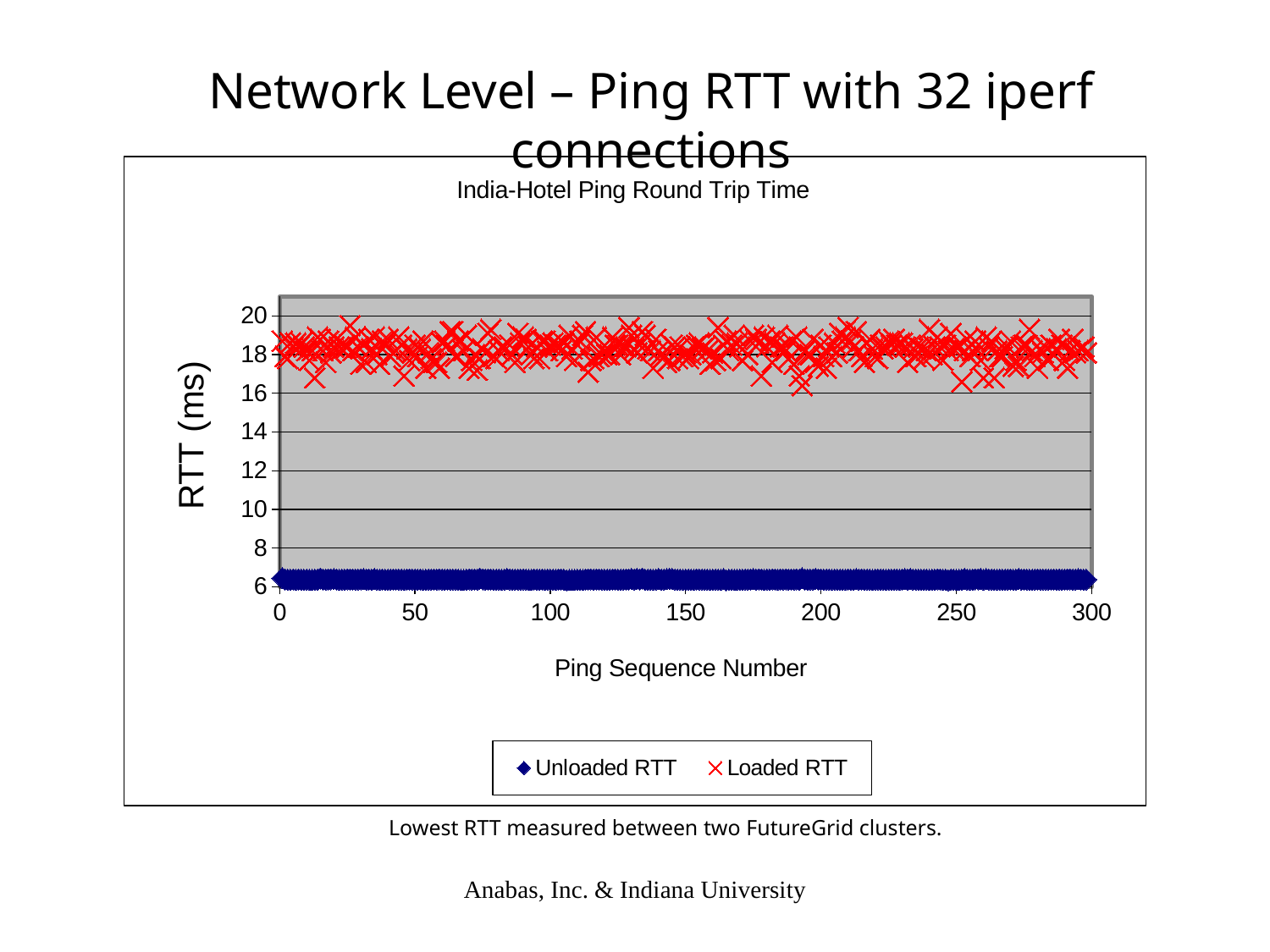
How many series does the legend list? 2 Are the Unloaded RTT values greater or less than 8 ms? less Are the Loaded RTT values greater or less than 20 ms? less Which series has the larger RTT values, Unloaded RTT or Loaded RTT? Loaded RTT What is the title of the chart? India-Hotel Ping Round Trip Time Which series is plotted with red x markers? Loaded RTT What kind of chart is shown on the slide? scatter chart Are the Loaded RTT values generally greater or less than 14 ms? greater What is the highest value shown on the x axis (Ping Sequence Number)? 300 Do the Unloaded RTT values rise, fall, or stay roughly flat as the ping sequence number increases? stay roughly flat Do the Loaded RTT values show a clear rising or falling trend across the ping sequence numbers, or do they stay roughly flat? stay roughly flat